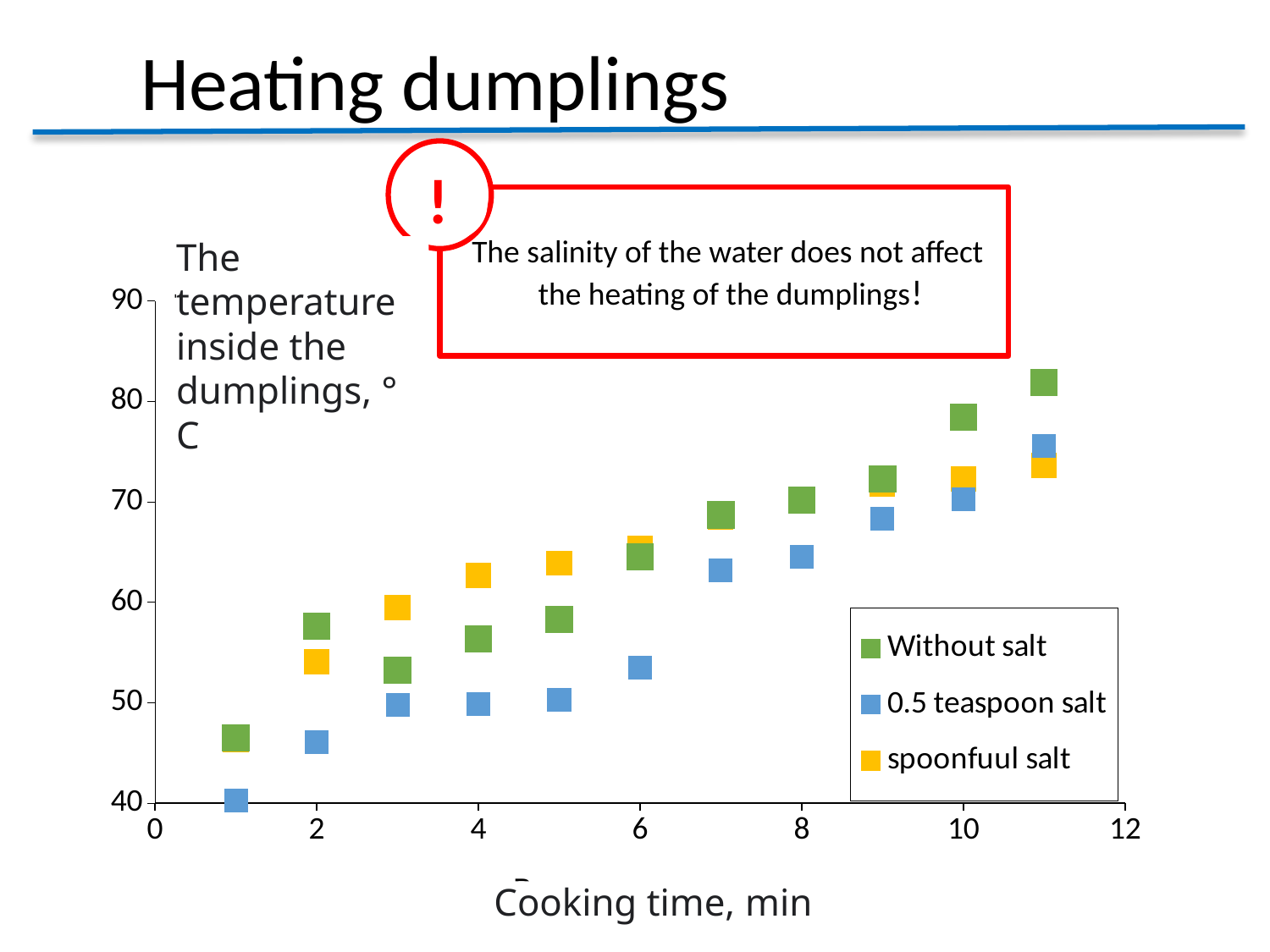
How many series does the legend list? 3 Is the value for 0.5 teaspoon salt at 6 minutes greater or less than 60? less At 4 minutes, which is higher: spoonfuul salt or 0.5 teaspoon salt? spoonfuul salt What kind of chart is shown on the slide? scatter chart Is the value for Without salt at 11 minutes greater or less than 80? greater At 11 minutes, which is higher: Without salt or 0.5 teaspoon salt? Without salt What are the three series named in the legend? Without salt, 0.5 teaspoon salt, spoonfuul salt Which series has the lowest temperature at 1 minute? 0.5 teaspoon salt Do the values for 0.5 teaspoon salt rise or fall as cooking time increases? rise What is the label of the x axis? Cooking time, min Is the value for spoonfuul salt at 3 minutes greater or less than 50? greater Which series has the highest temperature at 11 minutes? Without salt